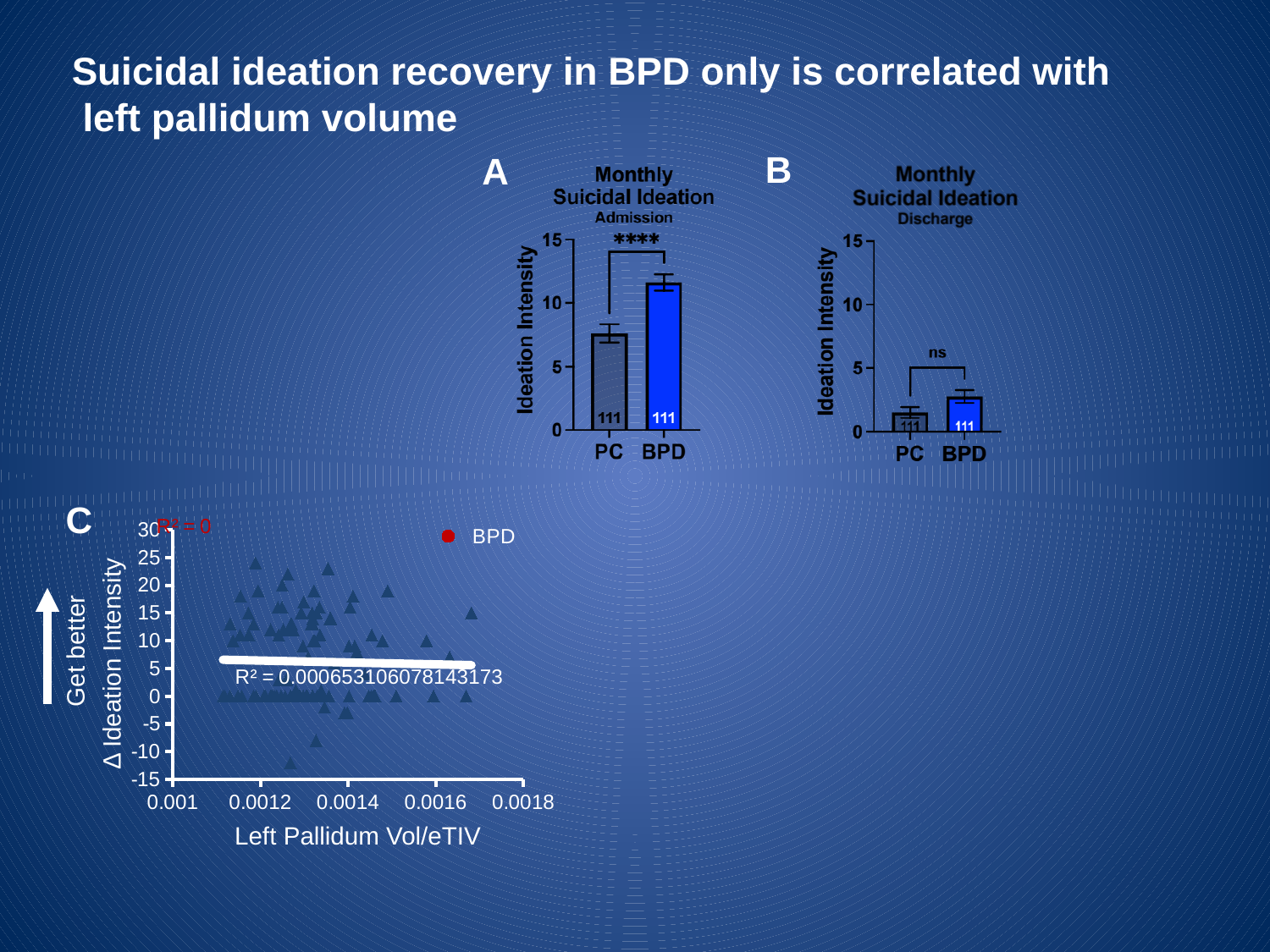
How many groups are plotted in chart A (Monthly Suicidal Ideation Admission)? 2 What kind of chart is chart C (bottom left)? scatter plot In chart A (Monthly Suicidal Ideation Admission), is the value for BPD greater or less than 10? greater What R² value is printed next to the fitted line in chart C (bottom left)? R² = 0.000653106078143173 What kind of chart is chart A (Monthly Suicidal Ideation Admission)? bar chart In chart A (Monthly Suicidal Ideation Admission), which group has the higher ideation intensity, PC or BPD? BPD In chart B (Monthly Suicidal Ideation Discharge), is the value for BPD greater or less than 5? less In chart B (Monthly Suicidal Ideation Discharge), is the value for PC greater or less than 5? less What significance annotation is shown above the bars in chart B (Monthly Suicidal Ideation Discharge)? ns How many series does the legend of chart C (bottom left) list? 1 In chart B (Monthly Suicidal Ideation Discharge), which group has the higher ideation intensity, PC or BPD? BPD